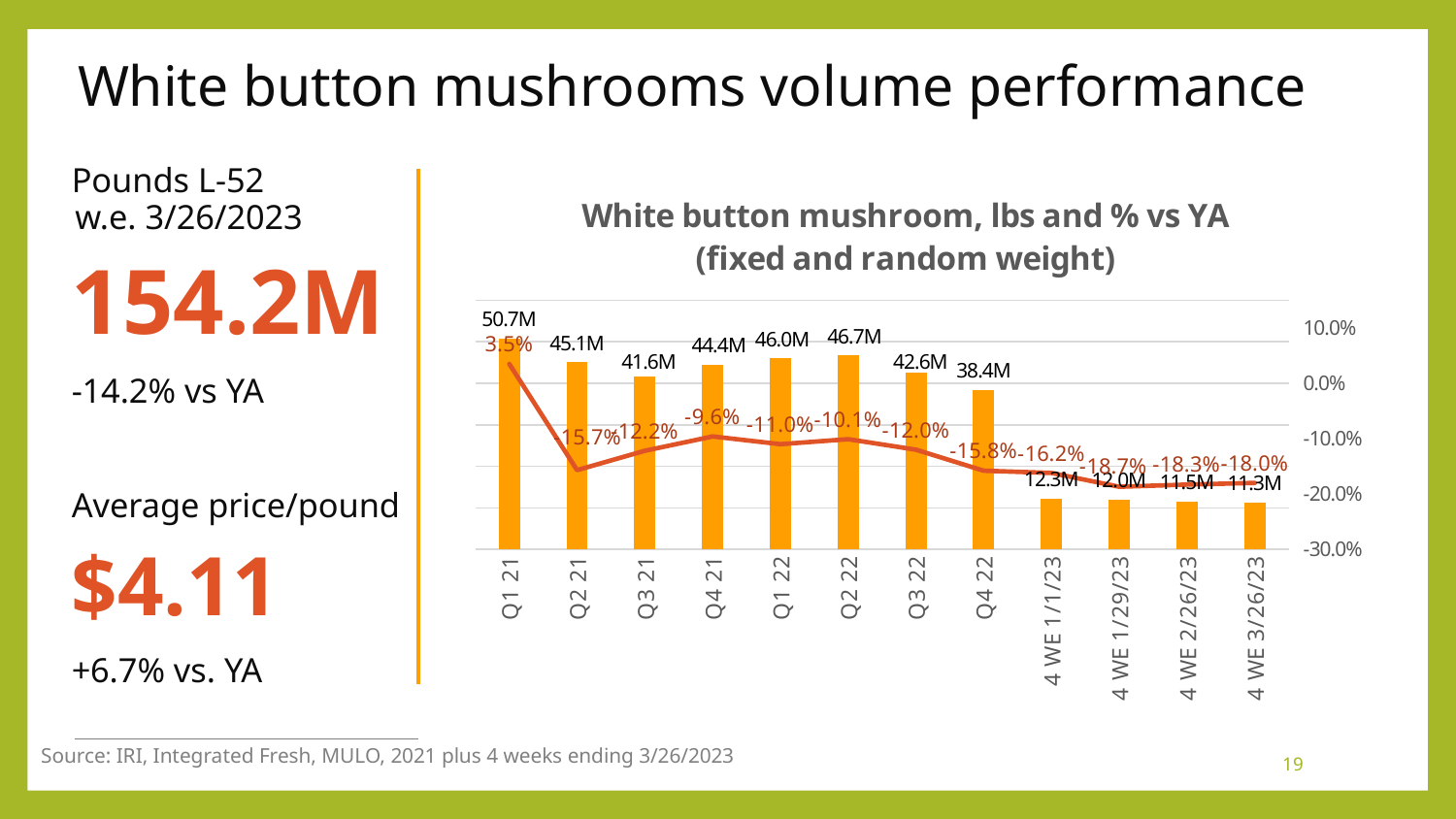
What is the volume in pounds for Q1 21? 50.7M Is the % vs YA value for Q3 22 greater or less than -10.0%? less Which category has the lowest volume in pounds? 4 WE 3/26/23 What kind of chart is this? Combined bar and line chart What is the % vs YA value for Q4 21? -9.6% What is the difference in pounds between Q1 21 and Q2 21? 5.6M Which category has the highest volume in pounds? Q1 21 What is the title of the chart? White button mushroom, lbs and % vs YA (fixed and random weight) What is the % vs YA value for 4 WE 1/29/23? -18.7% Which has a higher volume in pounds, Q3 21 or Q4 21? Q4 21 What is the volume in pounds for Q2 22? 46.7M How many categories are shown on the x axis? 12